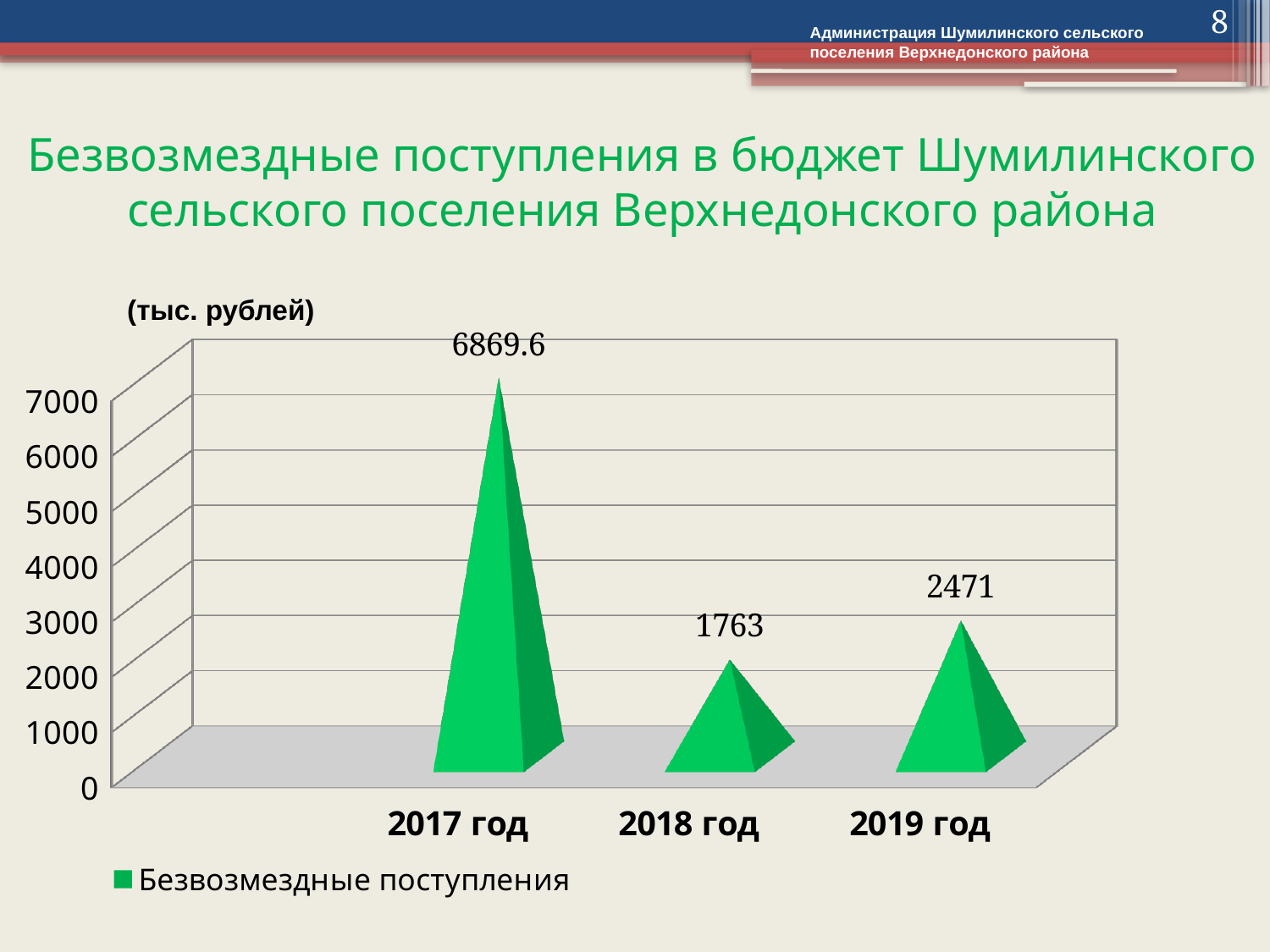
Which is larger, the value for 2018 год or 2019 год? 2019 год What is the value for 2018 год? 1763 What is the difference between the values for 2017 год and 2018 год? 5106.6 Which year has the lowest value? 2018 год How many years are shown on the x axis? 3 What is the value for 2017 год? 6869.6 What is the difference between the values for 2019 год and 2018 год? 708 Which year has the highest value? 2017 год What is the value for 2019 год? 2471 What series name does the legend show? Безвозмездные поступления Does the value rise or fall from 2018 год to 2019 год? rise Is the value for 2019 год greater or less than 3000? less